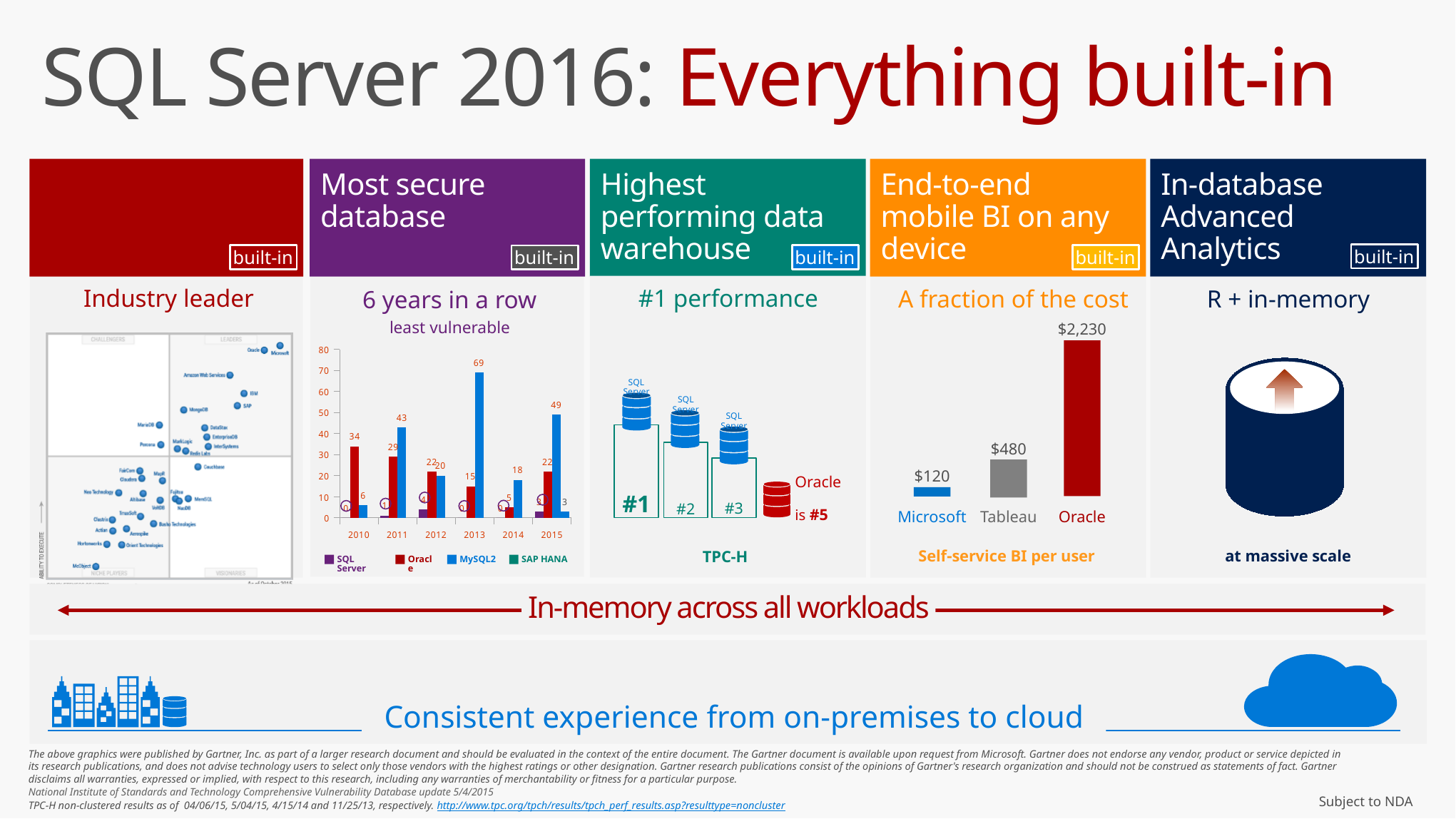
In the 'least vulnerable' chart, what is the value for MySQL2 in 2015? 49 In the 'Self-service BI per user' chart, what is the value for Oracle? $2,230 In the 'least vulnerable' chart, what is the difference between the MySQL2 and Oracle values in 2011? 14 What kind of chart is the 'least vulnerable' chart? bar chart How many series does the legend of the 'least vulnerable' chart list? 4 In the 'least vulnerable' chart, what is the value for Oracle in 2010? 34 In the 'least vulnerable' chart, which is larger in 2012: the Oracle value or the MySQL2 value? Oracle In the 'least vulnerable' chart, what is the value for MySQL2 in 2013? 69 In the 'Self-service BI per user' chart, what is the difference between the Tableau and Microsoft values? $360 In the 'least vulnerable' chart, in which year is the MySQL2 value highest? 2013 In the 'least vulnerable' chart, in which year is the Oracle value lowest? 2014 How many years are shown on the x axis of the 'least vulnerable' chart? 6